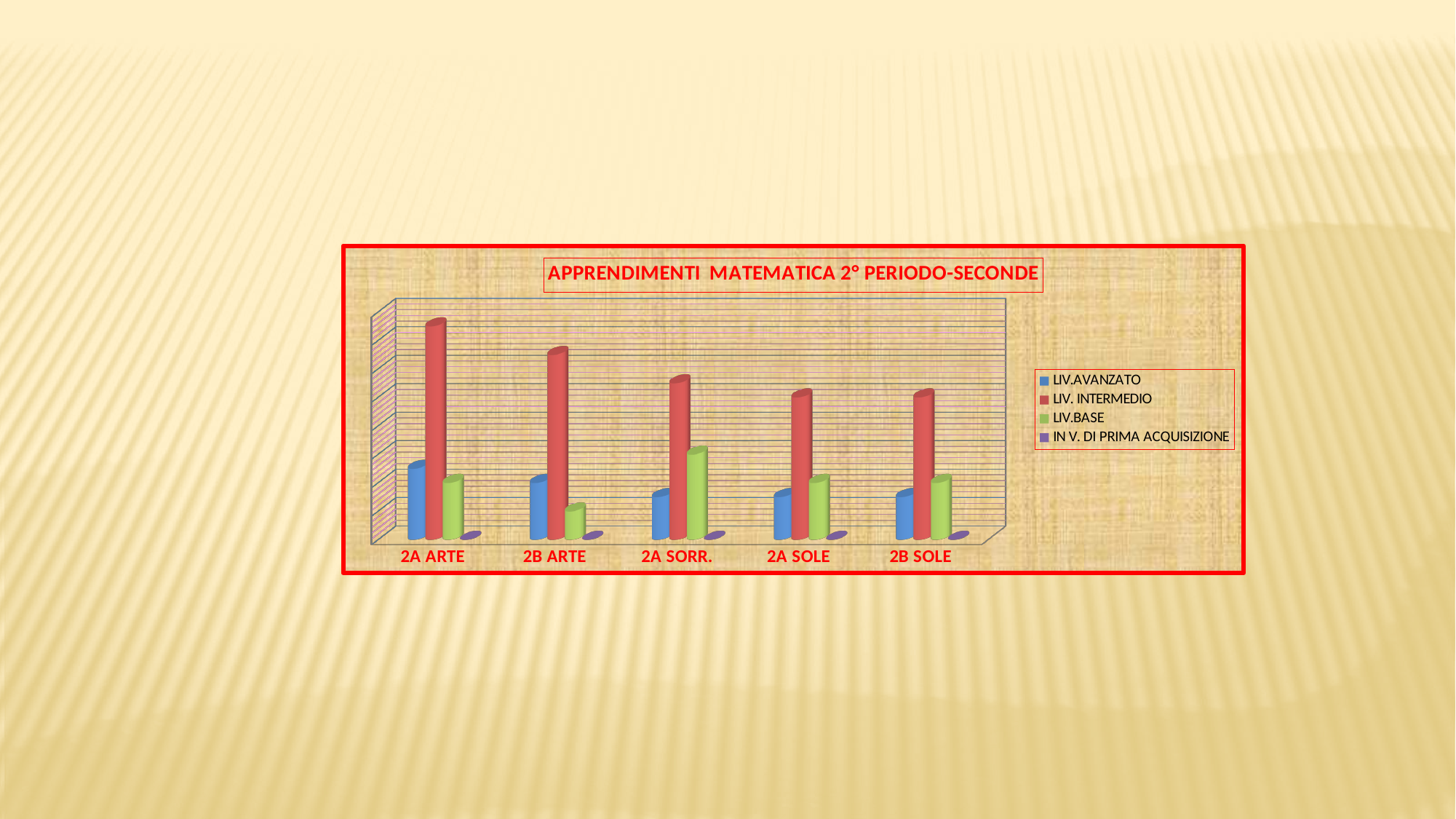
How many classes (categories) are shown on the x axis of the chart? 5 In 2A SORR., which is larger: LIV.AVANZATO or LIV.BASE? LIV.BASE What is the title of the chart? APPRENDIMENTI MATEMATICA 2° PERIODO-SECONDE Which class has the highest LIV. INTERMEDIO bar? 2A ARTE Which series is shown in red in the chart? LIV. INTERMEDIO How many series does the chart's legend list? 4 Which class has the lowest LIV.BASE bar? 2B ARTE Which class has the highest LIV.AVANZATO bar? 2A ARTE Does the LIV. INTERMEDIO value rise or fall from 2A ARTE to 2A SOLE? Fall Which class has the highest LIV.BASE bar? 2A SORR. What kind of chart is shown on the slide? Bar chart In 2B ARTE, which is larger: LIV.AVANZATO or LIV.BASE? LIV.AVANZATO